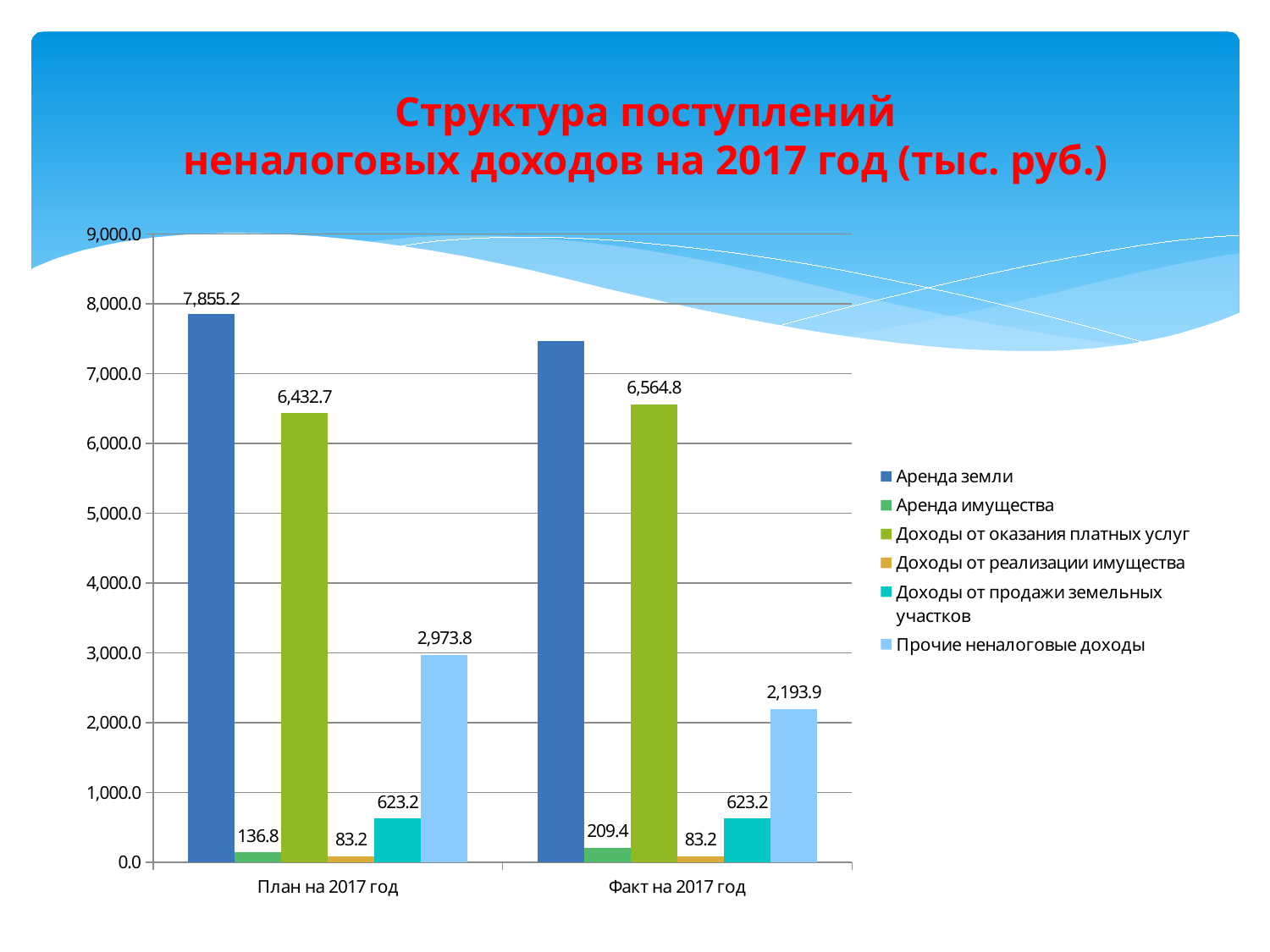
How many categories are shown on the x axis? 2 How many series does the legend list? 6 What is the value for Прочие неналоговые доходы in План на 2017 год? 2,973.8 Which series has the highest value in План на 2017 год? Аренда земли What is the value for Аренда земли in План на 2017 год? 7,855.2 What is the value for Аренда имущества in Факт на 2017 год? 209.4 Is the value for Аренда земли in Факт на 2017 год greater or less than 7,000.0? greater Which is larger: Доходы от оказания платных услуг in План на 2017 год or in Факт на 2017 год? Факт на 2017 год Which series has the lowest value in Факт на 2017 год? Доходы от реализации имущества What is the value for Доходы от оказания платных услуг in Факт на 2017 год? 6,564.8 What kind of chart is shown on the slide? Bar chart What is the difference between Прочие неналоговые доходы in План на 2017 год and in Факт на 2017 год? 779.9